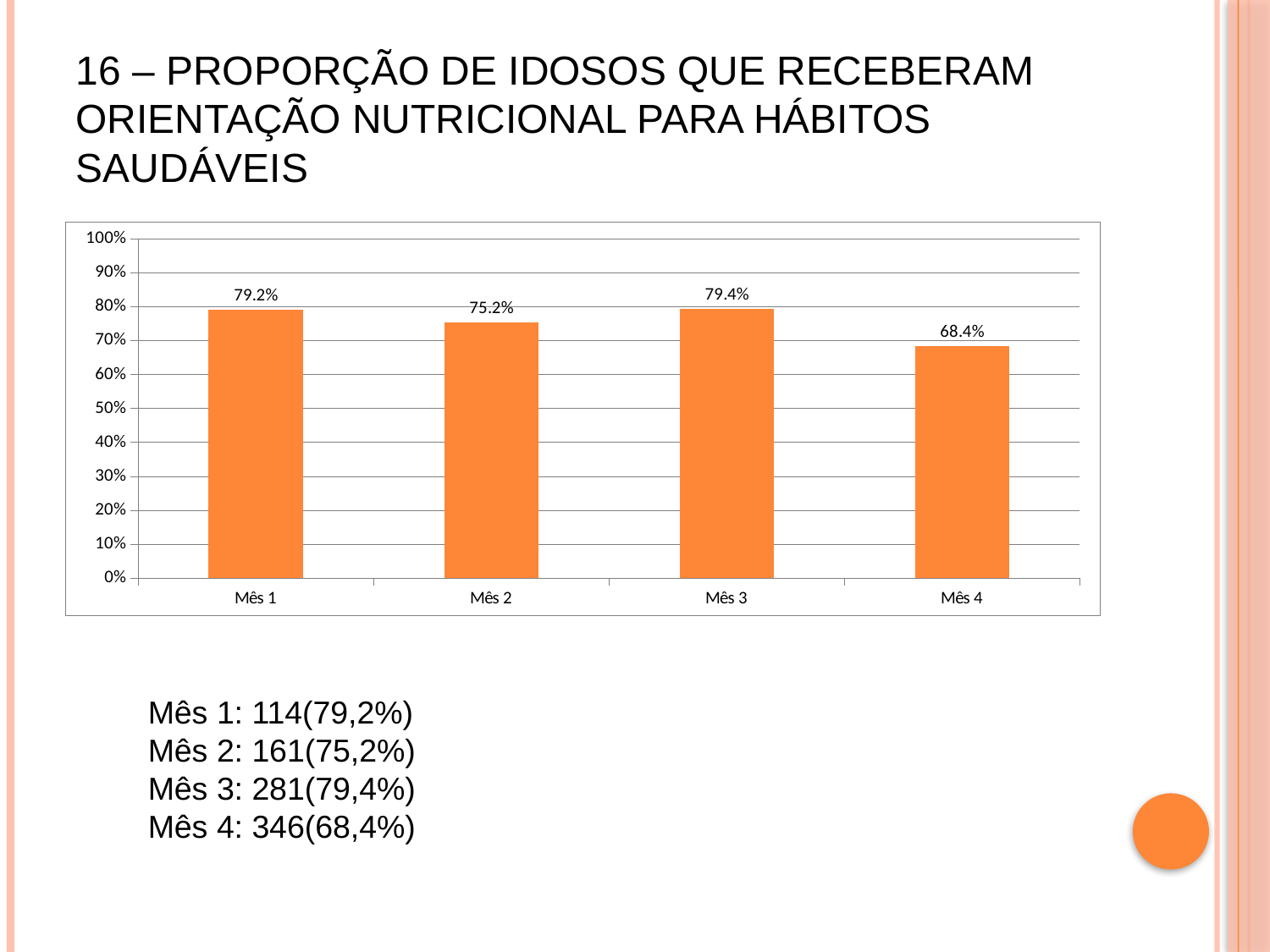
Does the value rise or fall from Mês 3 to Mês 4? fall What is the difference between the values for Mês 3 and Mês 4? 11.0 percentage points What is the value for Mês 1? 79.2% Is the value for Mês 4 greater or less than 70%? less What is the value for Mês 2? 75.2% What is the value for Mês 4? 68.4% Which month has the lowest value? Mês 4 Which is larger, the value for Mês 2 or the value for Mês 4? Mês 2 How many months are shown on the x axis? 4 Which month has the highest value? Mês 3 What kind of chart is shown on the slide? bar chart What is the difference between the values for Mês 1 and Mês 2? 4.0 percentage points